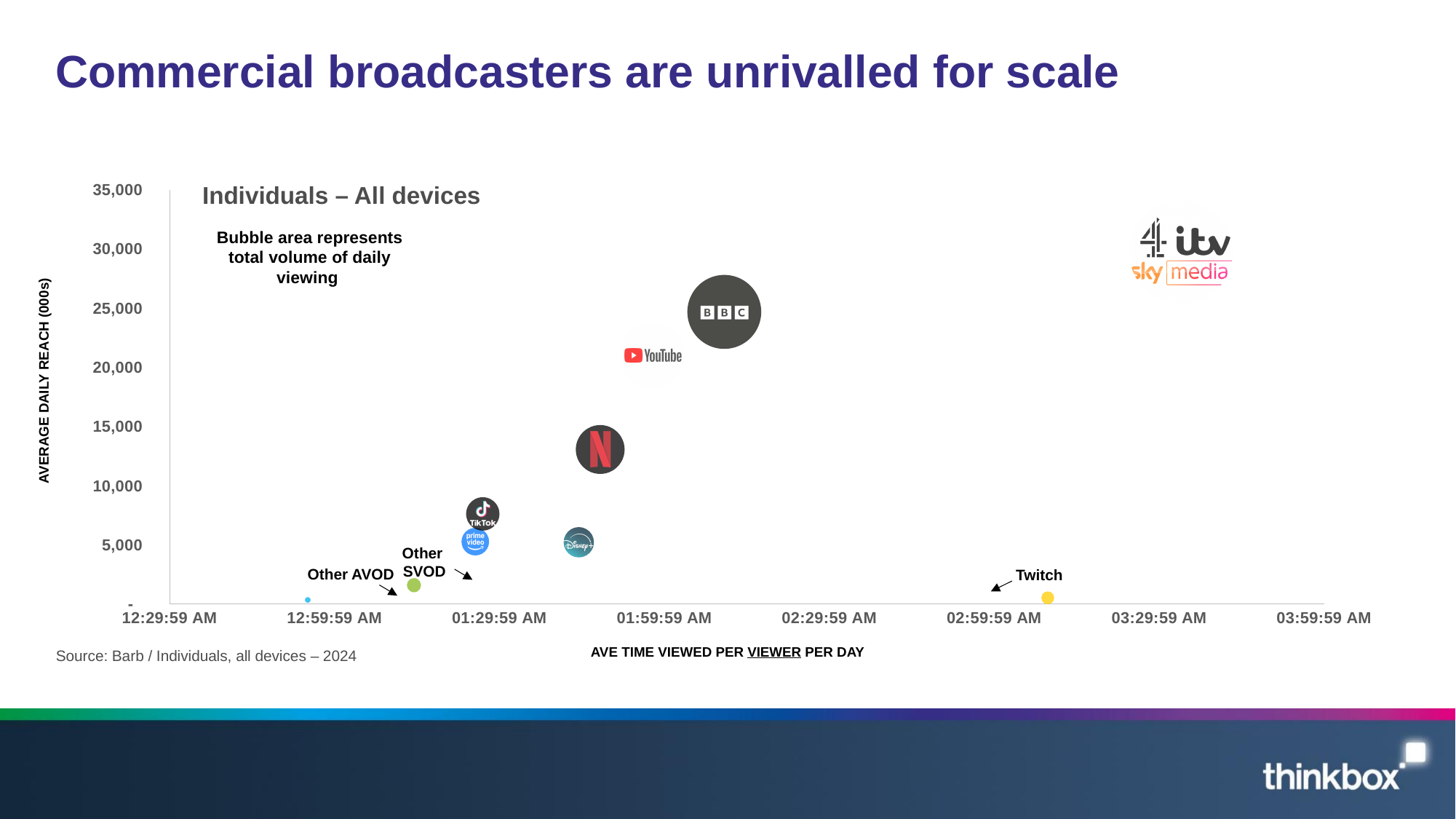
Is the average daily reach for Disney+ greater or less than 10,000? less What is the label of the vertical axis of the chart? AVERAGE DAILY REACH (000s) Which has the higher average time viewed per viewer per day, BBC or TikTok? BBC Is the average daily reach for Netflix greater or less than 10,000? greater Is the average daily reach for YouTube greater or less than 15,000? greater Which has the higher average daily reach, BBC or Netflix? BBC What kind of chart is shown on the slide? Bubble chart Which has the higher average daily reach, TikTok or Other SVOD? TikTok According to the note on the chart, what does the bubble area represent? Total volume of daily viewing